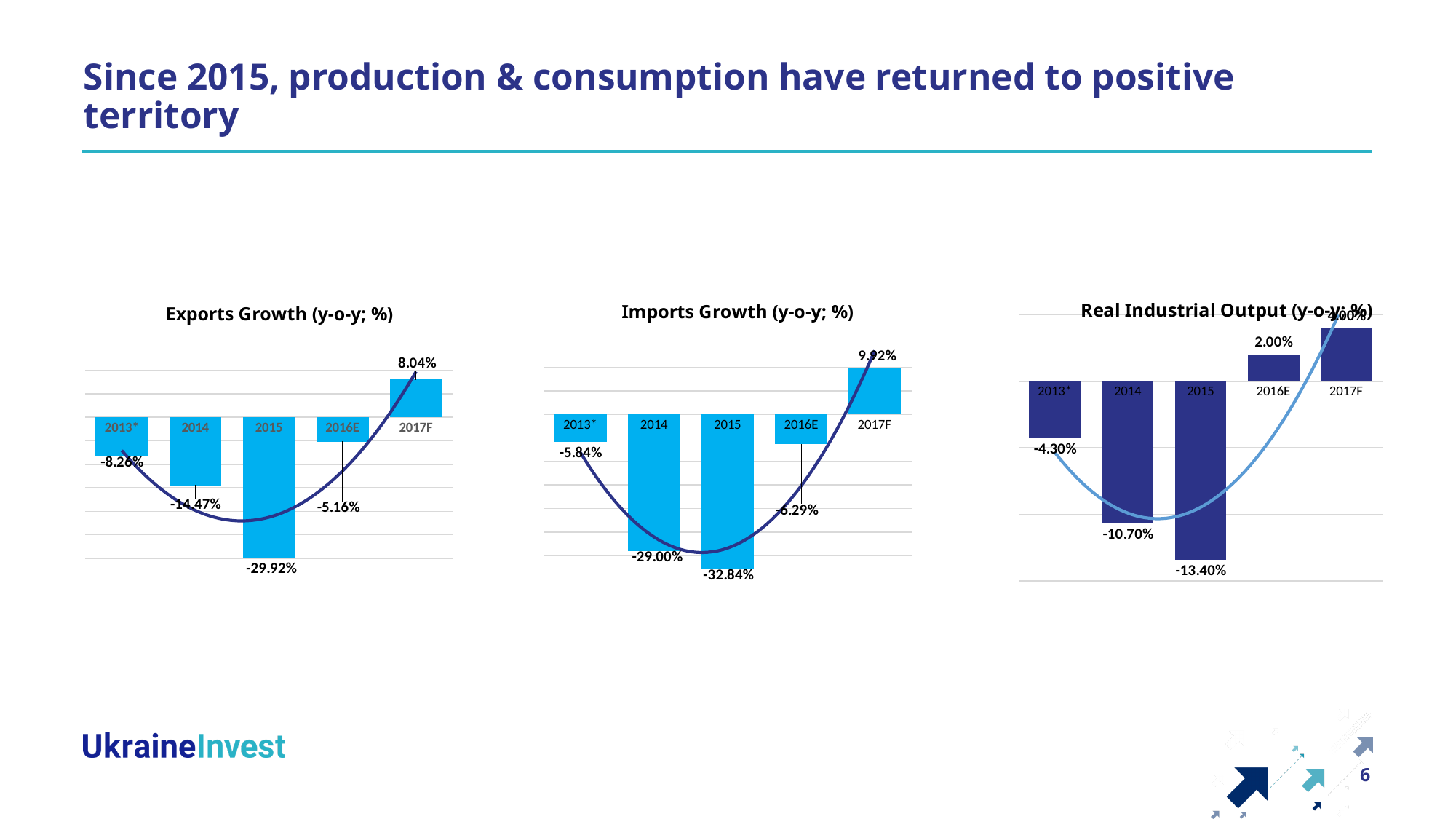
In the Exports Growth (y-o-y; %) chart, which year has the highest value? 2017F In the Real Industrial Output (y-o-y; %) chart, what is the value for 2016E? 2.00% In the Real Industrial Output (y-o-y; %) chart, do the values rise or fall from 2015 to 2017F? Rise In the Exports Growth (y-o-y; %) chart, what is the value for 2015? -29.92% In the Imports Growth (y-o-y; %) chart, which is larger, the value for 2013* or the value for 2016E? 2013* In the Real Industrial Output (y-o-y; %) chart, which year has the lowest value? 2015 In the Exports Growth (y-o-y; %) chart, what is the value for 2017F? 8.04% In the Imports Growth (y-o-y; %) chart, what is the value for 2014? -29.00% In the Exports Growth (y-o-y; %) chart, what is the difference between the 2014 value and the 2016E value? 9.31 percentage points In the Imports Growth (y-o-y; %) chart, which year has the lowest value? 2015 What kind of chart is the Exports Growth (y-o-y; %) chart? Bar chart How many years are shown in the Real Industrial Output (y-o-y; %) chart? 5